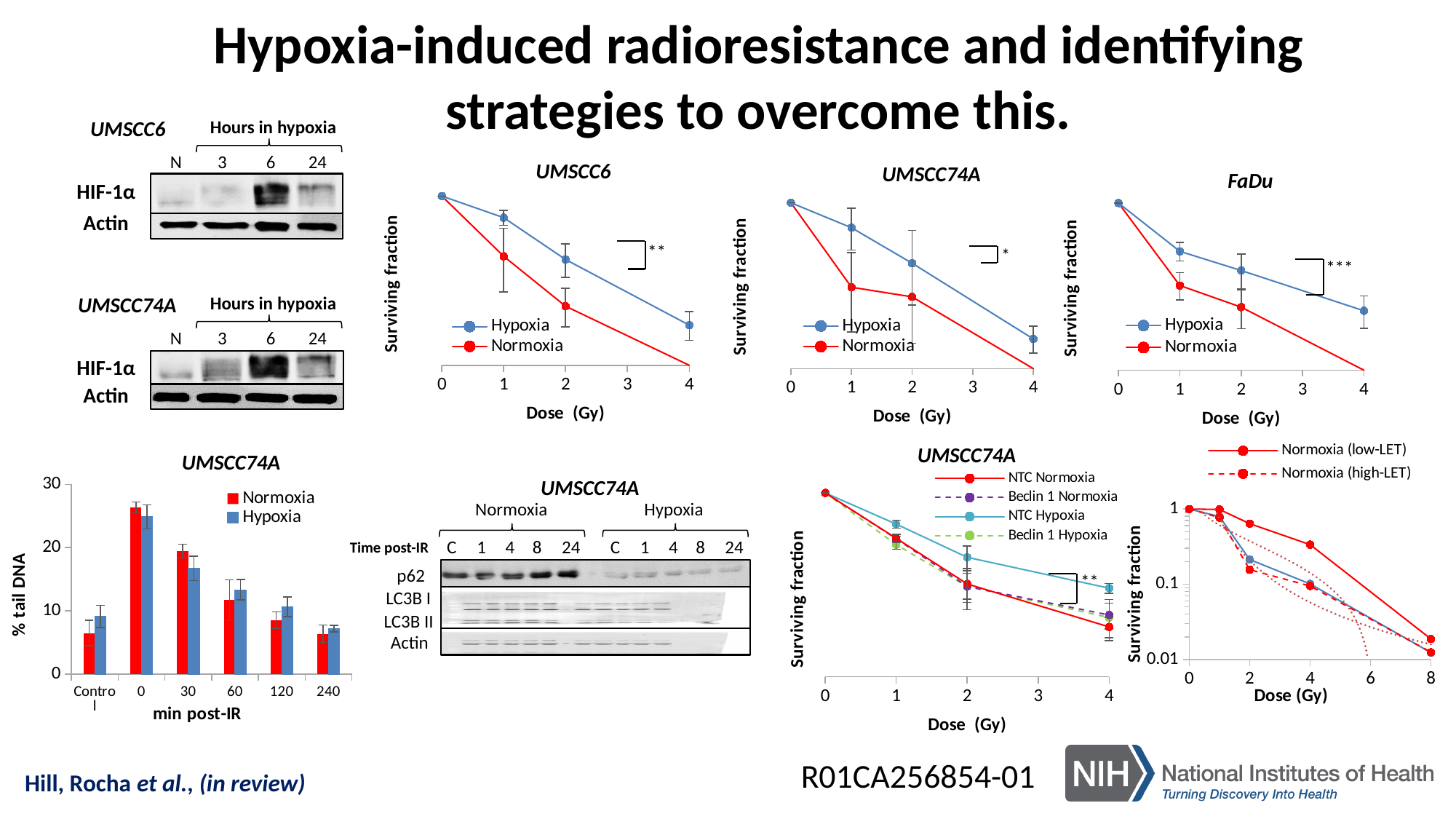
In the bottom-left % tail DNA bar chart, do the Normoxia values rise or fall from 0 to 240 min post-IR? fall In the bottom-left % tail DNA bar chart, is the Normoxia value at 0 min post-IR greater or less than 20? greater In the top UMSCC6 surviving fraction chart, which series is higher at 2 Gy, Hypoxia or Normoxia? Hypoxia In the bottom-left % tail DNA bar chart, how many categories are shown on the x axis? 6 What kind of chart is the bottom-left UMSCC74A chart showing % tail DNA? bar chart In the bottom-left % tail DNA bar chart, is the Hypoxia value at 240 min post-IR greater or less than 10? less In the bottom UMSCC74A surviving fraction line chart, how many series does the legend list? 4 In the bottom-left % tail DNA bar chart, how many series does the legend list? 2 In the bottom-left % tail DNA bar chart, which is larger at 30 min post-IR, Normoxia or Hypoxia? Normoxia In the bottom-left % tail DNA bar chart, at which time point is the Normoxia bar highest? 0 In the bottom-right chart with the log y axis, is the Normoxia (low-LET) value at 4 Gy greater or less than 0.1? greater In the bottom-right chart with the log y axis, what are the two series listed in the legend? Normoxia (low-LET) and Normoxia (high-LET)